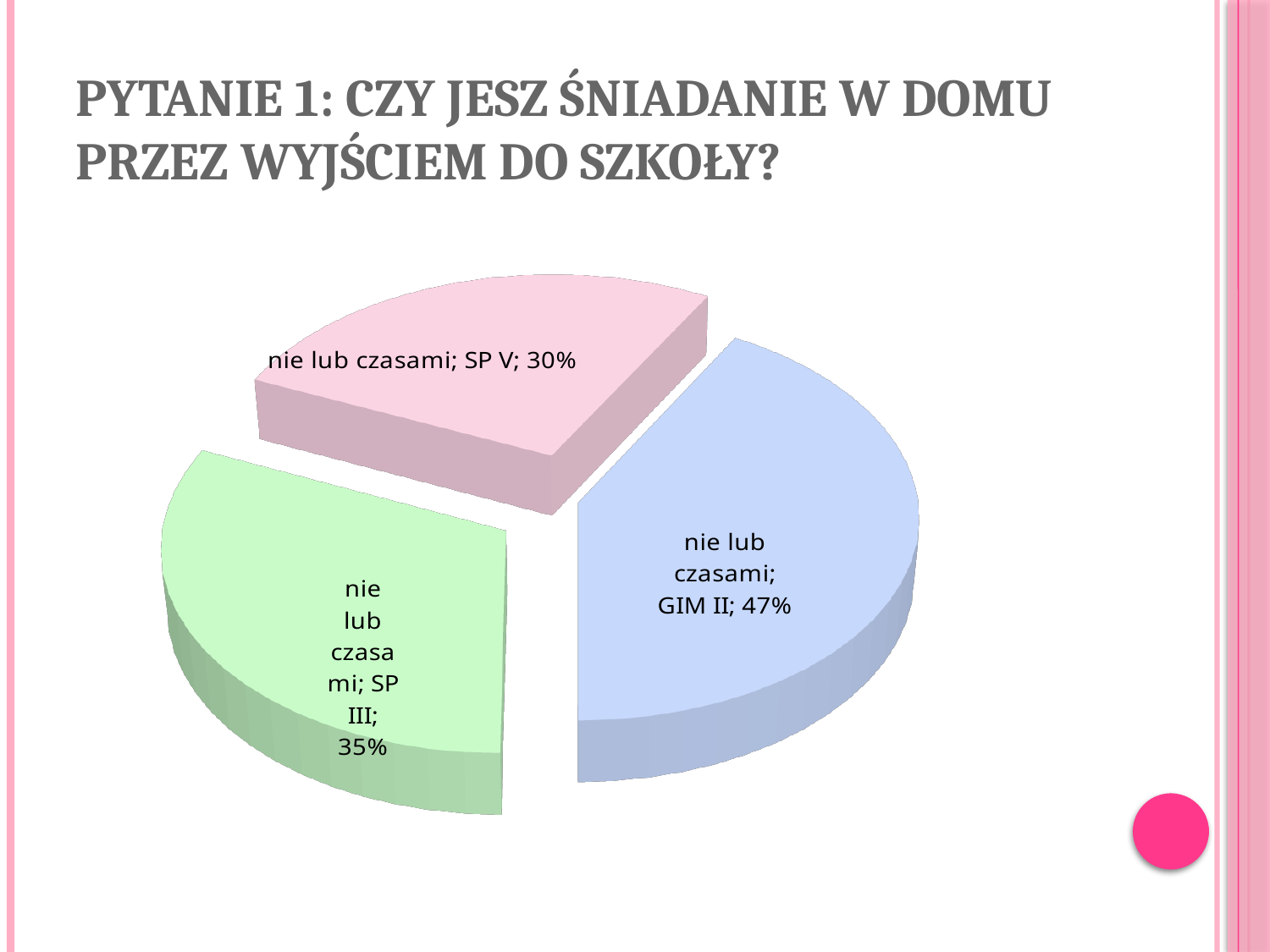
Which category has the highest value? GIM II What value is shown for GIM II? 47% What series name appears in the data labels of the pie chart? nie lub czasami What kind of chart is shown on the slide? pie chart What colour is the slice for GIM II? blue What is the difference between the values for SP III and SP V? 5% What value is shown for SP III? 35% Which is larger, the value for SP III or the value for SP V? SP III Which category has the lowest value? SP V What is the difference between the values for GIM II and SP V? 17% How many slices does the pie chart have? 3 What value is shown for SP V? 30%